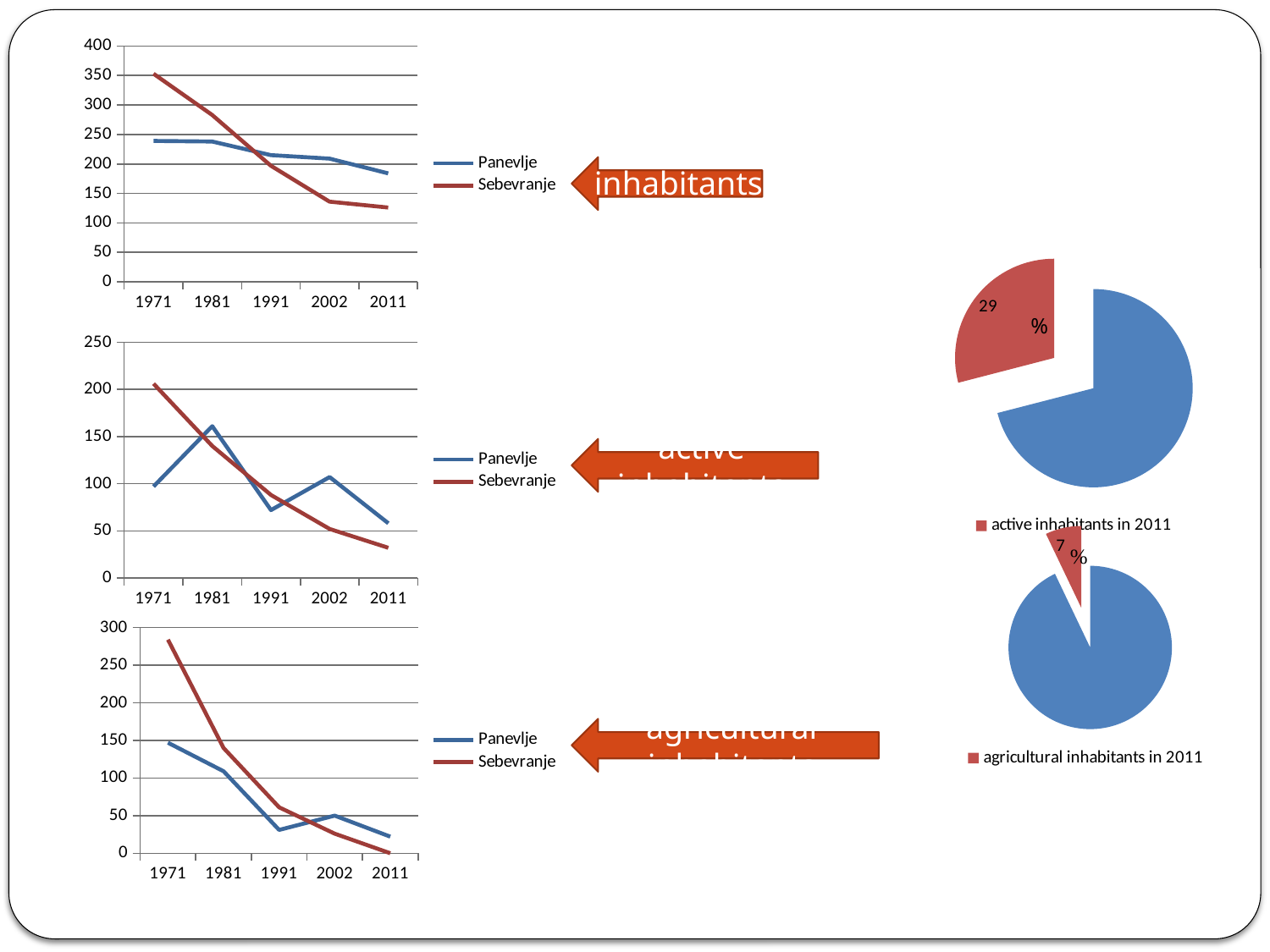
In the bottom-left "agricultural inhabitants" chart, is the value for Sebevranje in 1971 greater or less than 250? greater In the top-left "inhabitants" chart, does the Sebevranje line rise or fall from 1971 to 2011? fall In the bottom-left "agricultural inhabitants" chart, which series has the higher value in 2011, Panevlje or Sebevranje? Panevlje In the middle-left "active inhabitants" chart, is the value for Sebevranje in 2011 greater or less than 50? less In the top-left "inhabitants" chart, how many series does the legend list? 2 In the top-left "inhabitants" chart, is the value for Sebevranje in 1971 greater or less than 300? greater In the middle-left "active inhabitants" chart, which series has the higher value in 1971, Panevlje or Sebevranje? Sebevranje In the pie chart labelled "agricultural inhabitants in 2011", what share does the red slice represent? 7% In the bottom-left "agricultural inhabitants" chart, how many years are shown on the x axis? 5 In the top-left "inhabitants" chart, which series has the higher value in 2011, Panevlje or Sebevranje? Panevlje In the pie chart labelled "active inhabitants in 2011", what share does the red slice represent? 29% What kind of chart is the top-left chart labelled "inhabitants"? line chart